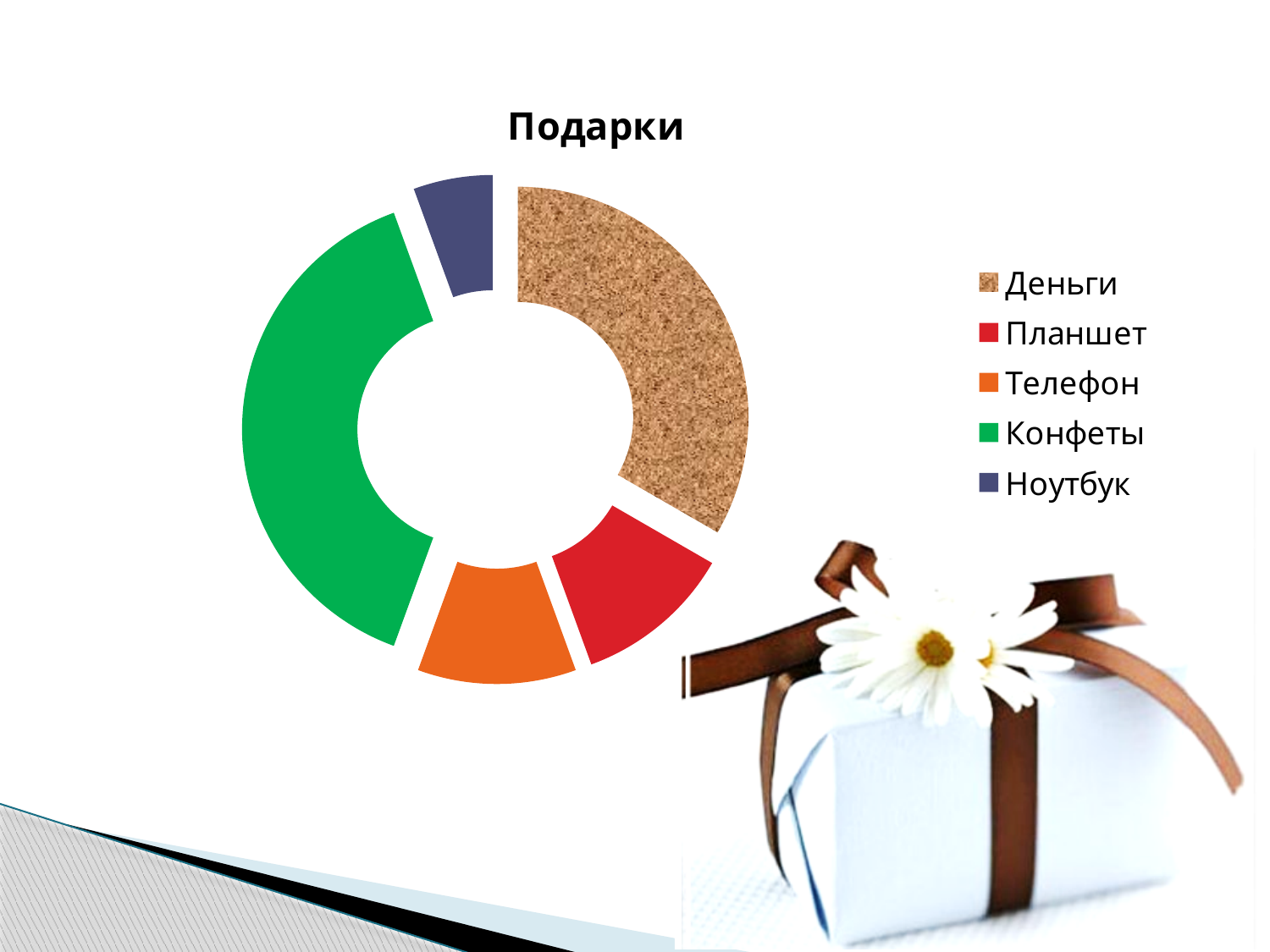
Which slice is larger, Конфеты or Ноутбук? Конфеты Which category is shown in green in the chart? Конфеты How many categories does the chart show? 5 Which category has the largest slice in the chart? Конфеты Which category is listed first in the legend? Деньги Which category has the smallest slice in the chart? Ноутбук What kind of chart is shown on the slide? Doughnut chart Which slice is larger, Конфеты or Телефон? Конфеты Which slice is larger, Ноутбук or Планшет? Планшет What is the title of the chart? Подарки